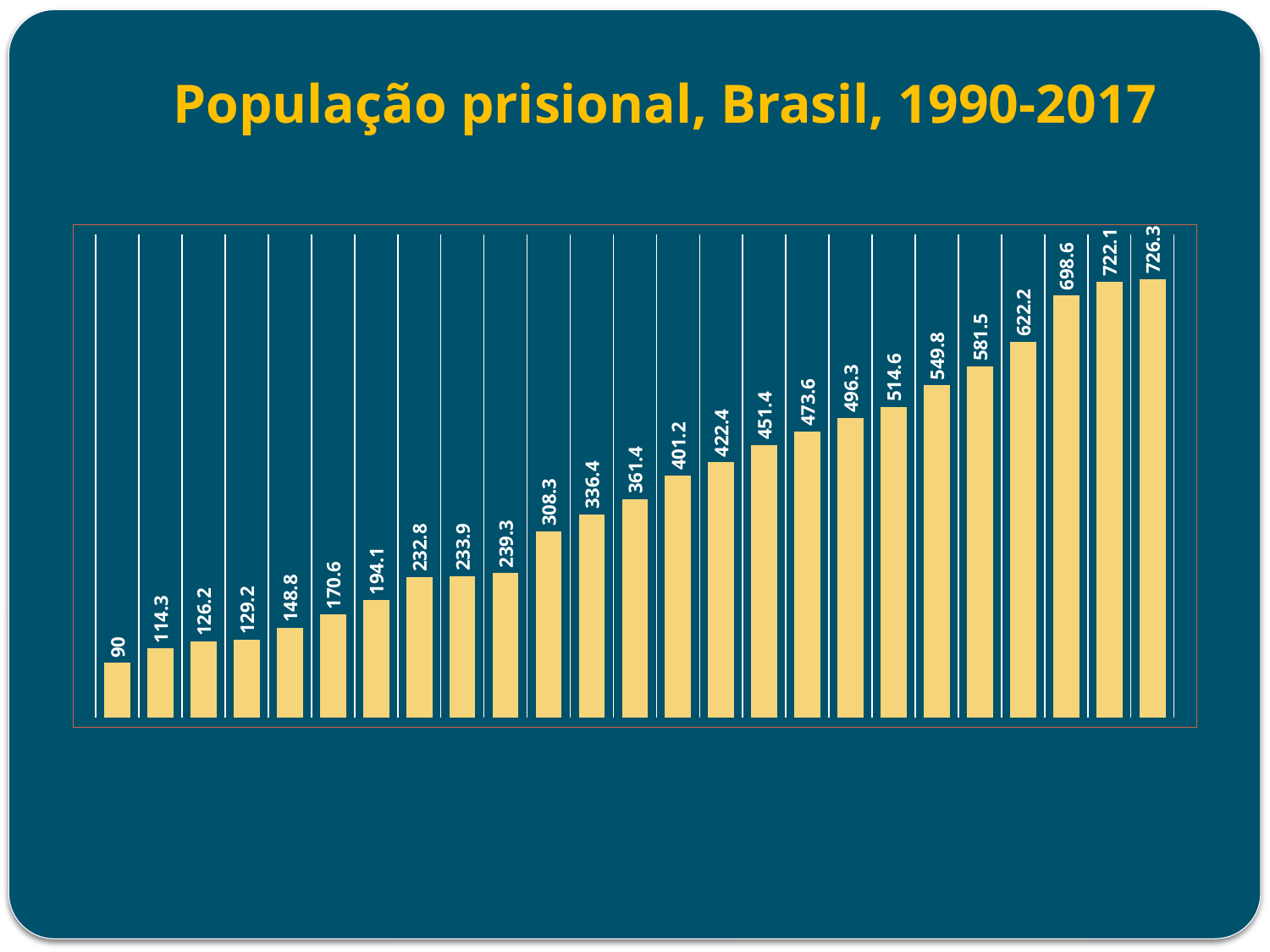
How many bars are plotted in the chart? 25 Do the values generally rise or fall from left to right across the chart? rise What is the value of the last (rightmost) bar? 726.3 What is the difference between the rightmost bar and the leftmost bar? 636.3 What is the highest value shown in the chart? 726.3 What is the difference between the two rightmost bars (726.3 and 722.1)? 4.2 What kind of chart is shown on the slide? bar chart What is the title of the chart? População prisional, Brasil, 1990-2017 What is the lowest value shown in the chart? 90 What is the value of the second bar from the left? 114.3 What is the value of the first (leftmost) bar? 90 Which is larger, the value of the leftmost bar or the value of the rightmost bar? the rightmost bar